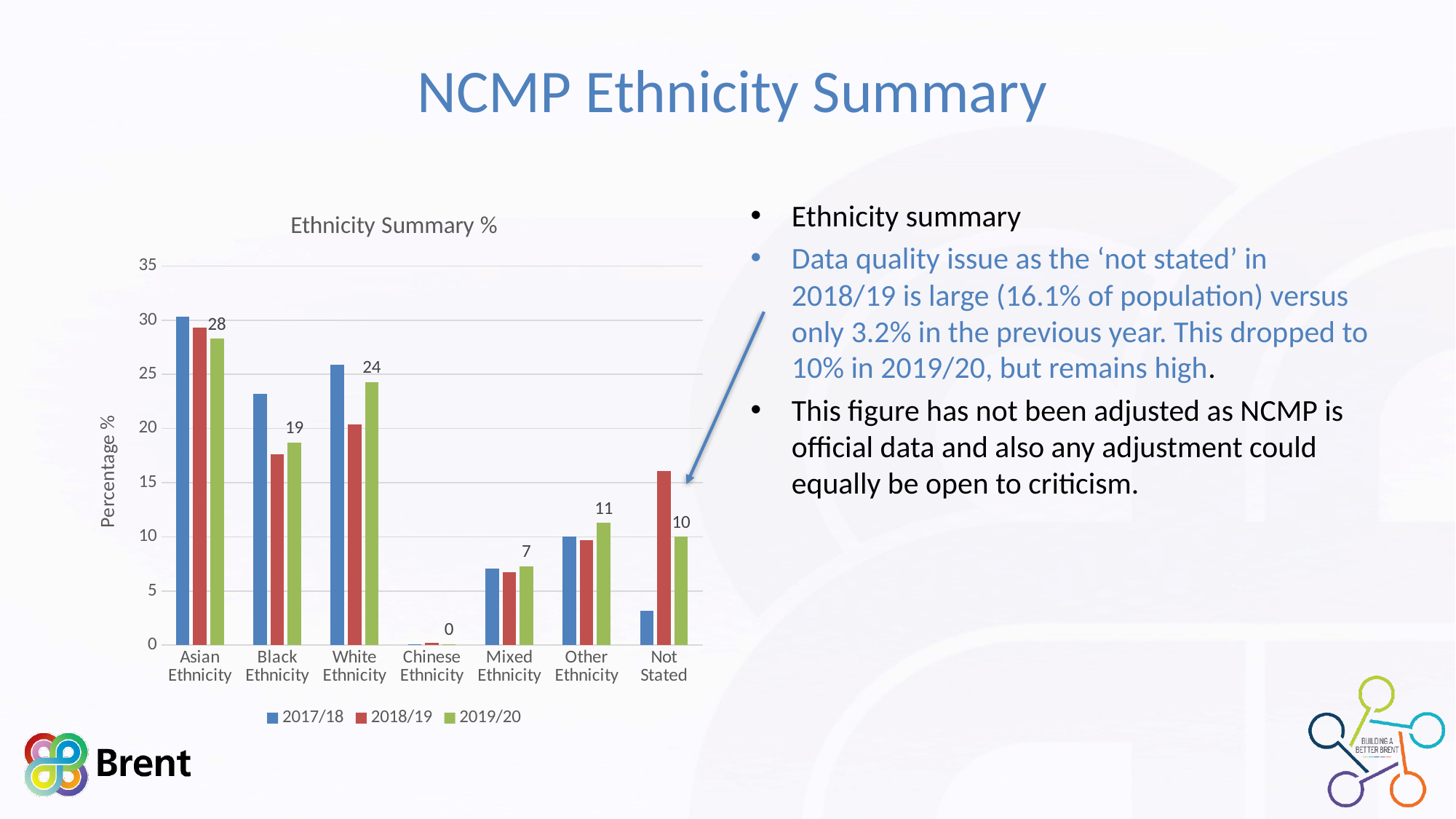
What type of chart is shown on the slide? Bar chart How many ethnicity categories are shown on the x axis of the chart? 7 What is the 2019/20 value for Black Ethnicity? 19 Which category has the lowest 2019/20 value? Chinese Ethnicity Which category has the highest 2019/20 value? Asian Ethnicity Which has the larger 2019/20 value, Black Ethnicity or White Ethnicity? White Ethnicity Is the 2018/19 value for Not Stated greater or less than 15? greater What is the difference between the 2019/20 values for Asian Ethnicity and White Ethnicity? 4 What is the title of the y axis of the chart? Percentage % What is the 2019/20 value for Asian Ethnicity? 28 How many series does the legend of the Ethnicity Summary % chart list? 3 What is the 2019/20 value for Not Stated? 10